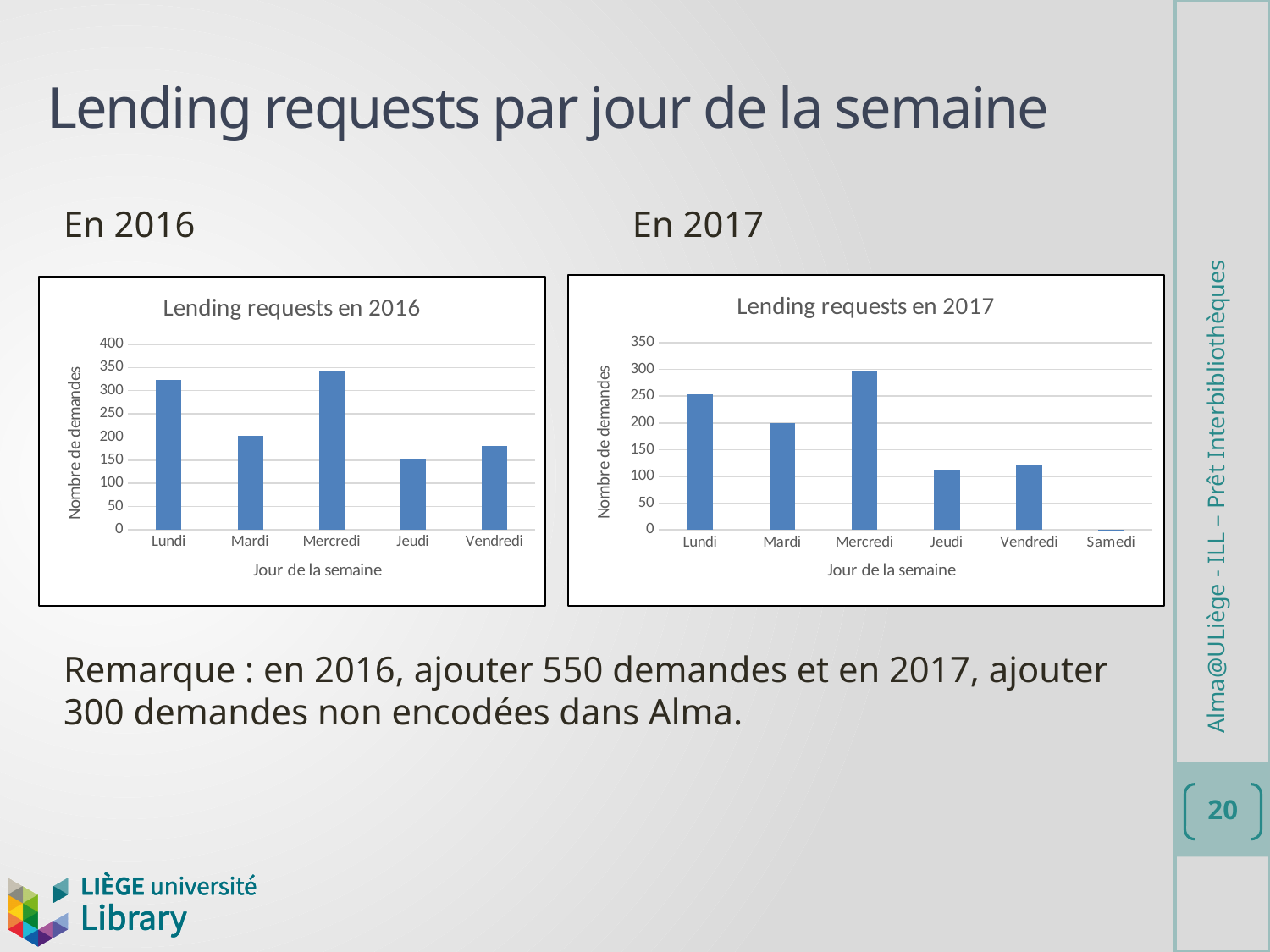
What type of chart is the chart titled "Lending requests en 2016"? Bar chart In the chart titled "Lending requests en 2016", is the value for Lundi greater or less than 300? greater In the chart titled "Lending requests en 2017", is the value for Jeudi greater or less than 150? less How many days are shown on the x axis of the chart titled "Lending requests en 2017"? 6 In the chart titled "Lending requests en 2016", which is larger, the value for Mardi or the value for Vendredi? Mardi In the chart titled "Lending requests en 2017", which day has the highest number of requests? Mercredi In the chart titled "Lending requests en 2017", which day has the lowest number of requests? Samedi How many days are shown on the x axis of the chart titled "Lending requests en 2016"? 5 In the chart titled "Lending requests en 2017", is the value for Lundi greater or less than 200? greater In the chart titled "Lending requests en 2016", which day has the lowest number of requests? Jeudi In the chart titled "Lending requests en 2017", which is larger, the value for Lundi or the value for Mercredi? Mercredi In the chart titled "Lending requests en 2016", which day has the highest number of requests? Mercredi